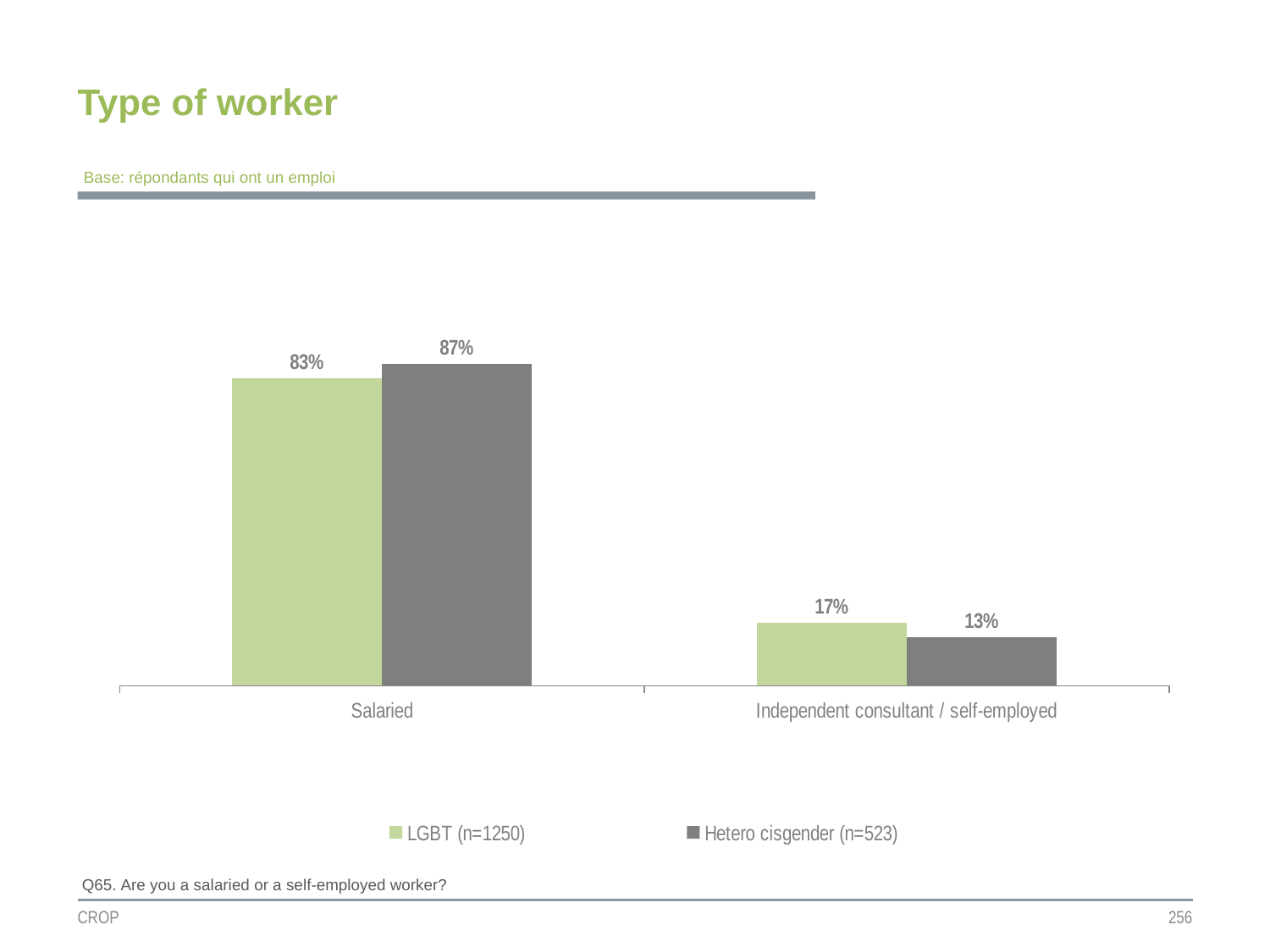
What kind of chart is shown on the slide? Bar chart What is the difference between the LGBT and Hetero cisgender values for Independent consultant / self-employed? 4% What is the difference between the Hetero cisgender and LGBT values for Salaried? 4% How many categories are shown on the x axis? 2 How many series does the legend list? 2 What percentage of LGBT respondents are independent consultants / self-employed? 17% What percentage of Hetero cisgender respondents are salaried workers? 87% Which group has the larger share of salaried workers, LGBT or Hetero cisgender? Hetero cisgender Which category has the lowest value for the LGBT series? Independent consultant / self-employed What percentage of Hetero cisgender respondents are independent consultants / self-employed? 13% What percentage of LGBT respondents are salaried workers? 83% Which category has the highest value for the Hetero cisgender series? Salaried